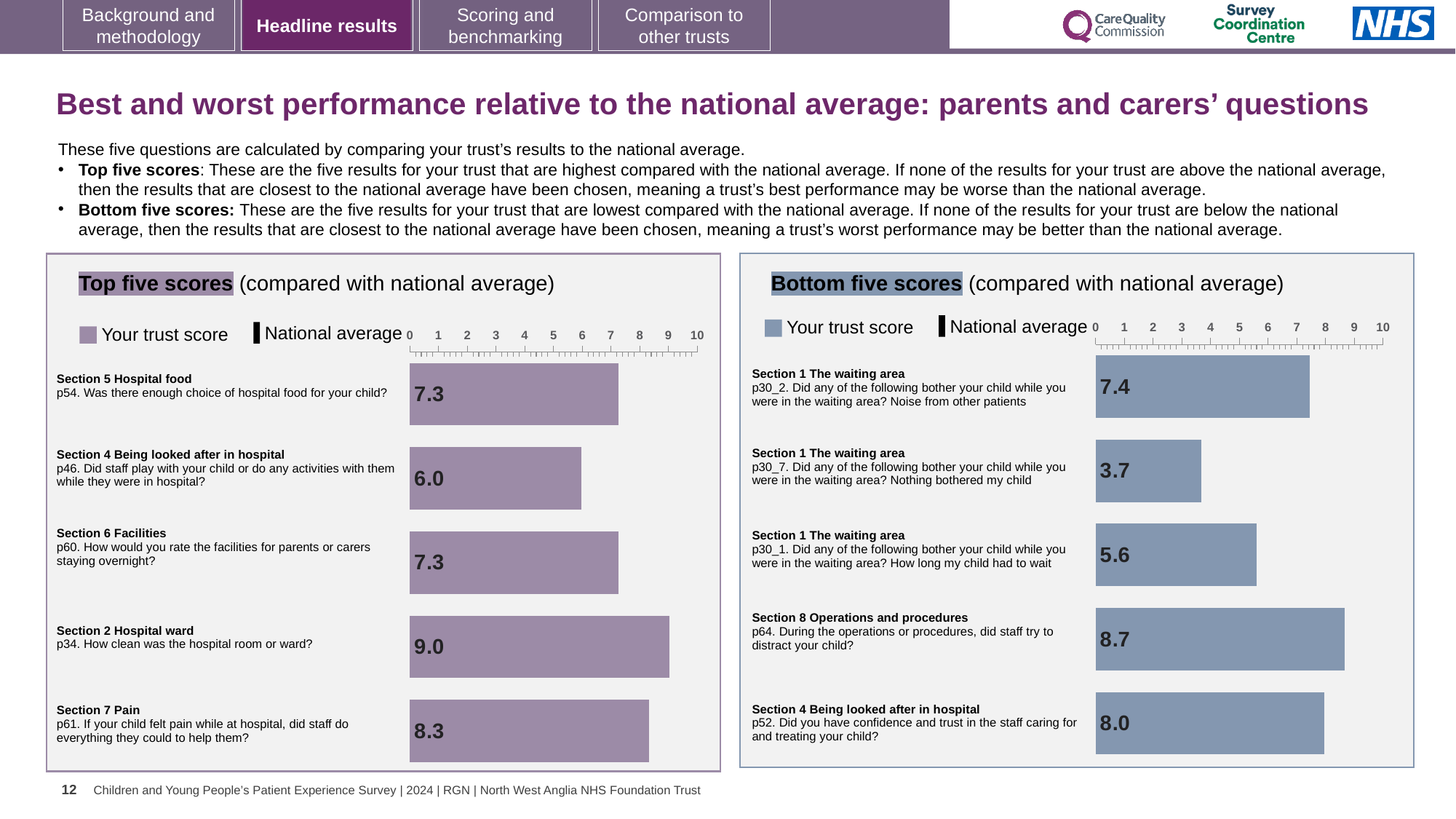
In the Top five scores chart, what is the trust score for p34. How clean was the hospital room or ward? 9.0 What type of chart is used in the Top five scores panel? Bar chart In the Bottom five scores chart, what is the trust score for p64. During the operations or procedures, did staff try to distract your child? 8.7 In the Top five scores chart, how many questions are plotted? 5 In the Bottom five scores chart, which question has the lowest trust score? p30_7. Did any of the following bother your child while you were in the waiting area? Nothing bothered my child In the Bottom five scores chart, what is the difference between the trust scores for p64 (staff distracting your child) and p52 (confidence and trust in staff)? 0.7 In the Bottom five scores chart, what is the trust score for p30_7. Did any of the following bother your child while you were in the waiting area? Nothing bothered my child? 3.7 In the Top five scores chart, which question has the lowest trust score? p46. Did staff play with your child or do any activities with them while they were in hospital? In the Top five scores chart, what is the difference between the trust scores for p34 (hospital room or ward cleanliness) and p61 (staff helping with pain)? 0.7 In the Bottom five scores chart, which is larger: the trust score for p30_2 (Noise from other patients) or for p30_1 (How long my child had to wait)? p30_2 (Noise from other patients) In the Top five scores chart, which question has the highest trust score? p34. How clean was the hospital room or ward? In the Top five scores chart, what is the trust score for p46. Did staff play with your child or do any activities with them while they were in hospital? 6.0